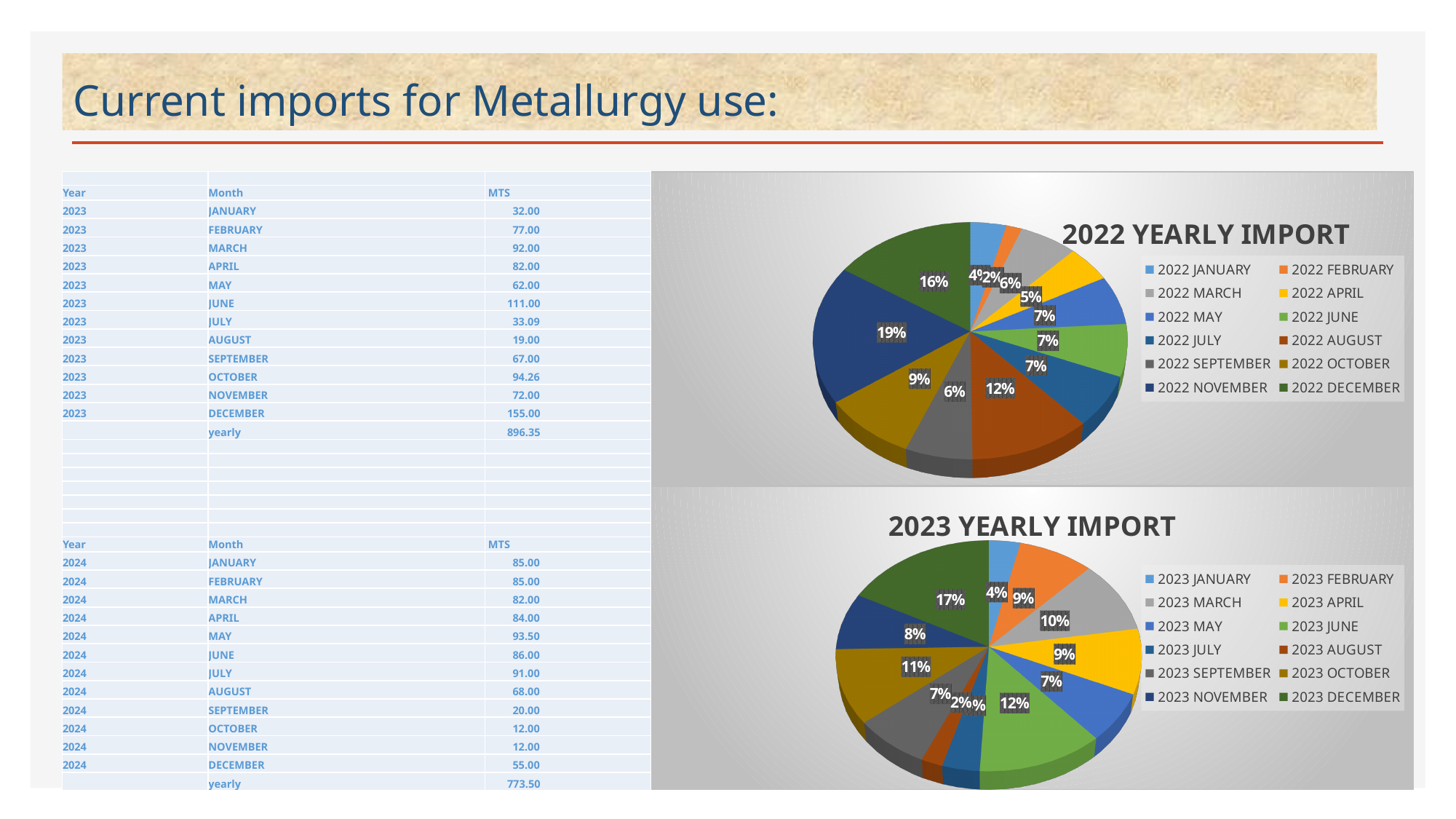
In the 2023 YEARLY IMPORT pie chart, which month has the largest share? 2023 DECEMBER In the 2022 YEARLY IMPORT pie chart, what is the difference between the shares of 2022 NOVEMBER and 2022 DECEMBER? 3% In the 2023 YEARLY IMPORT pie chart, which has the larger share, 2023 OCTOBER or 2023 NOVEMBER? 2023 OCTOBER In the 2022 YEARLY IMPORT pie chart, what share does 2022 AUGUST have? 12% In the 2022 YEARLY IMPORT pie chart, which month has the smallest share? 2022 FEBRUARY In the 2023 YEARLY IMPORT pie chart, what share does 2023 DECEMBER have? 17% What is the title of the lower pie chart on the slide? 2023 YEARLY IMPORT In the 2022 YEARLY IMPORT pie chart, which month has the largest share? 2022 NOVEMBER In the 2022 YEARLY IMPORT pie chart, what share does 2022 NOVEMBER have? 19% How many entries does the legend of the 2022 YEARLY IMPORT chart list? 12 What type of chart is the 2022 YEARLY IMPORT chart? pie chart